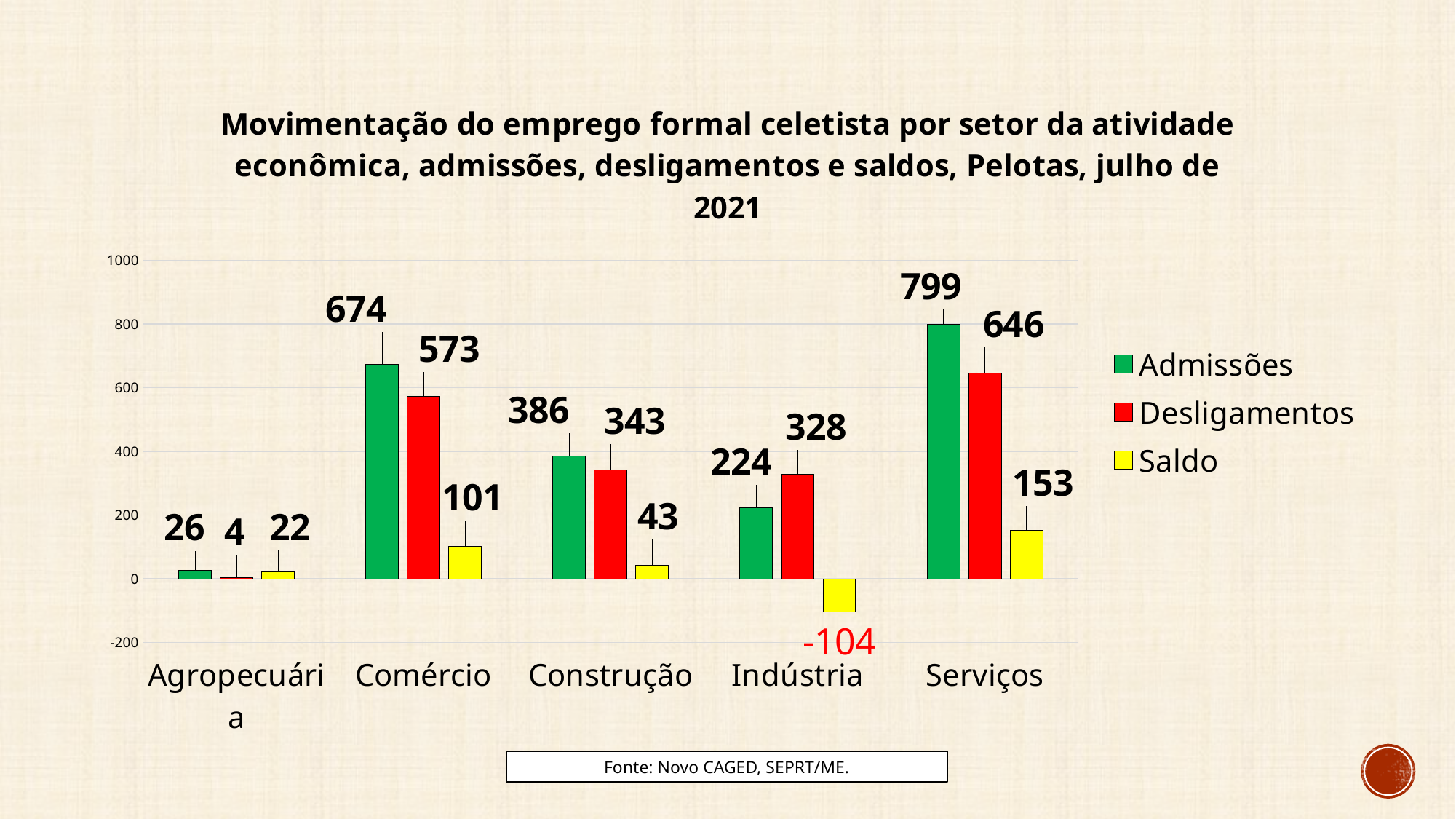
Which sector has the highest Admissões value? Serviços What is the Saldo value for Indústria? -104 What is the difference between Admissões and Desligamentos for Construção? 43 How many sectors are shown on the x axis? 5 What is the source cited below the chart? Novo CAGED, SEPRT/ME. Which is larger for Indústria, Admissões or Desligamentos? Desligamentos How many series does the legend list? 3 What kind of chart is shown on the slide? Bar chart Which sector has the lowest Desligamentos value? Agropecuária What colour represents the Saldo series? Yellow What is the Admissões value for Comércio? 674 What is the Desligamentos value for Serviços? 646